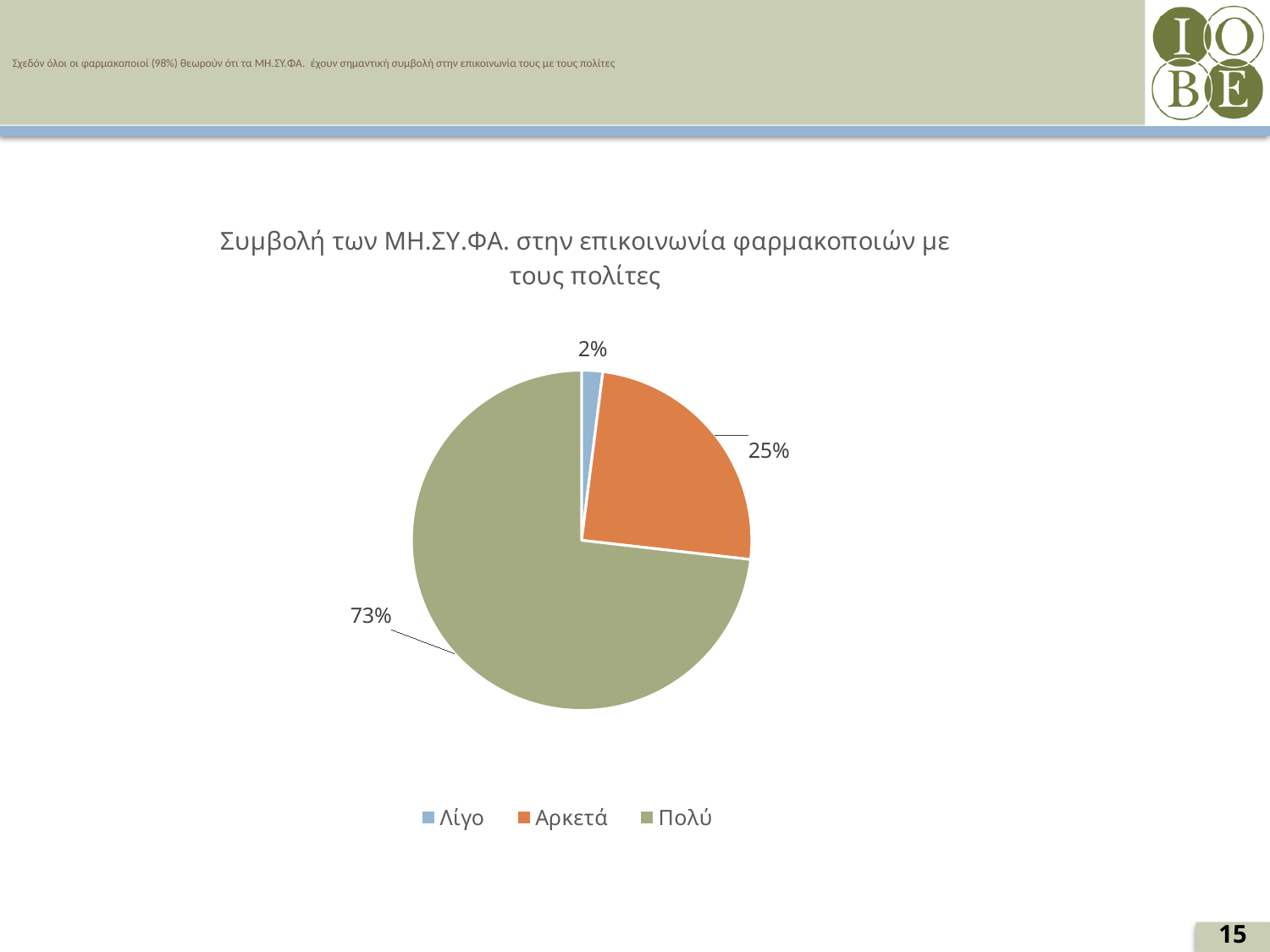
What kind of chart is shown on the slide? Pie chart How many categories does the pie chart show? 3 What is the difference in percentage points between the Πολύ and Αρκετά slices? 48 Which category has the smallest slice of the pie? Λίγο What share of the pie does the Αρκετά slice represent? 25% Which category has the largest slice of the pie? Πολύ Which slice is larger, Αρκετά or Λίγο? Αρκετά What share of the pie does the Λίγο slice represent? 2% What is the title of the chart? Συμβολή των ΜΗ.ΣΥ.ΦΑ. στην επικοινωνία φαρμακοποιών με τους πολίτες Which category is shown in orange in the legend? Αρκετά What share of the pie does the Πολύ slice represent? 73% What is the combined share of the Πολύ and Αρκετά slices? 98%